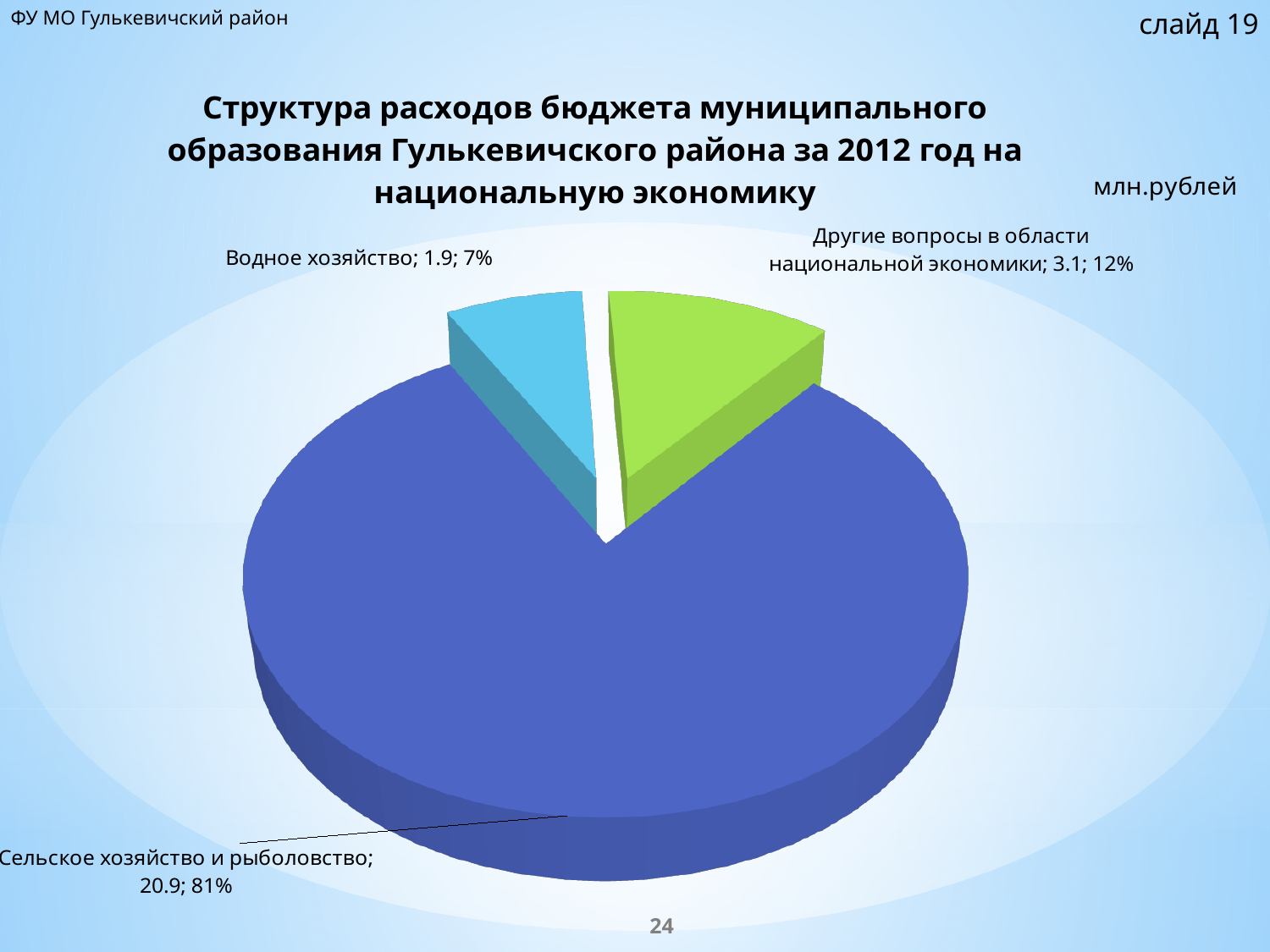
What share of the pie does Другие вопросы в области национальной экономики represent? 12% What share of the pie does Сельское хозяйство и рыболовство represent? 81% What is the value for Сельское хозяйство и рыболовство? 20.9 Which category has the largest slice? Сельское хозяйство и рыболовство How many slices does the pie chart have? 3 In what units are the values on the chart given? млн.рублей What kind of chart is shown on the slide? pie chart What is the value for Другие вопросы в области национальной экономики? 3.1 What share of the pie does Водное хозяйство represent? 7% What is the value for Водное хозяйство? 1.9 Which category has the smallest slice? Водное хозяйство What is the difference between the values for Сельское хозяйство и рыболовство and Другие вопросы в области национальной экономики? 17.8